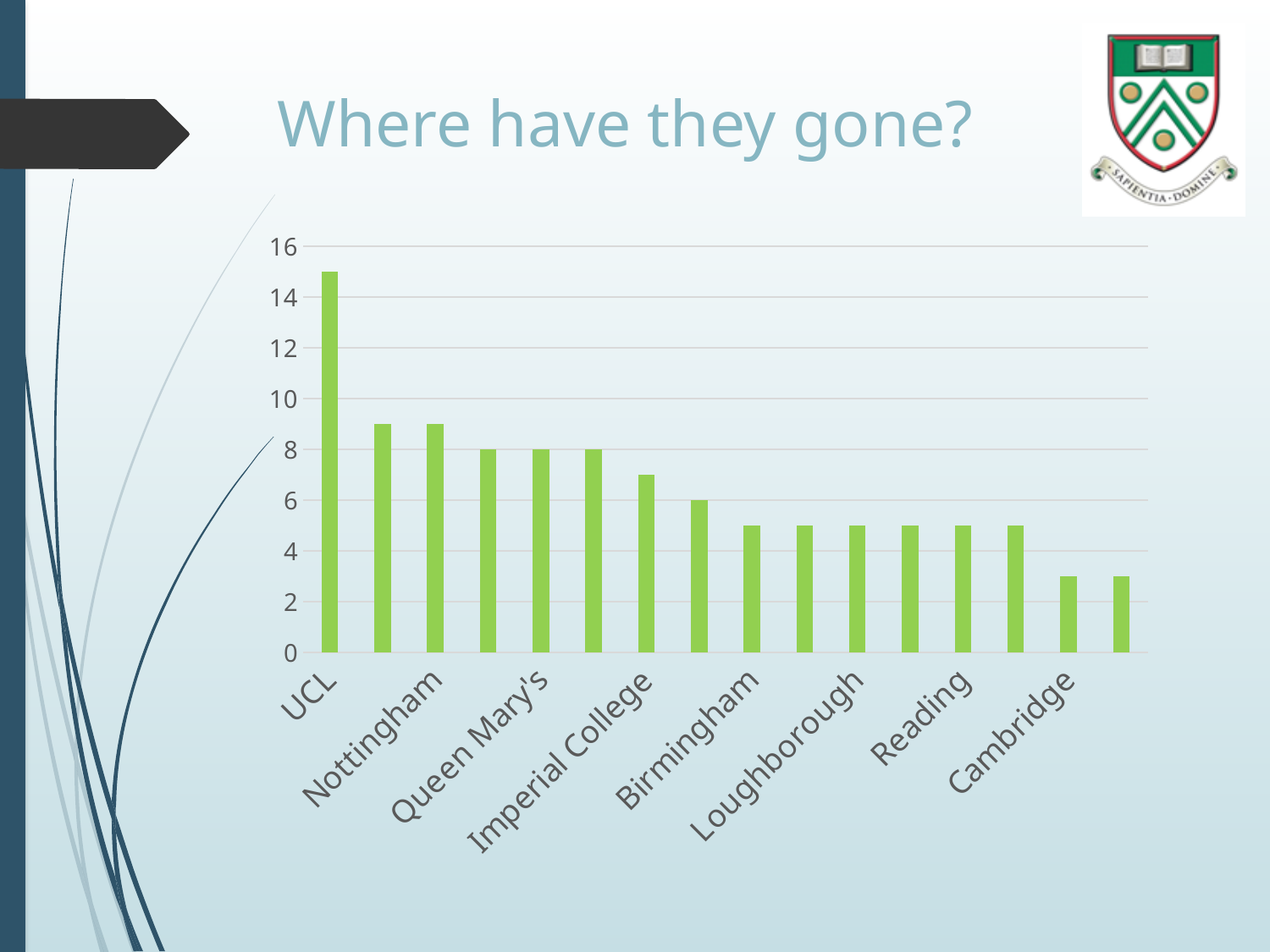
What is the title of the chart? Where have they gone? Which is larger, the value for Imperial College or the value for Reading? Imperial College Is the value for Cambridge greater or less than 4? less Is the value for UCL greater or less than 14? greater What type of chart is shown on the slide? bar chart Is the value for Birmingham greater or less than 4? greater Which university has the highest bar in the chart? UCL What is the value for Queen Mary's? 8 How many bars are plotted in the chart? 16 Which is larger, the value for UCL or the value for Nottingham? UCL Do the bar values generally rise or fall from left to right across the chart? fall